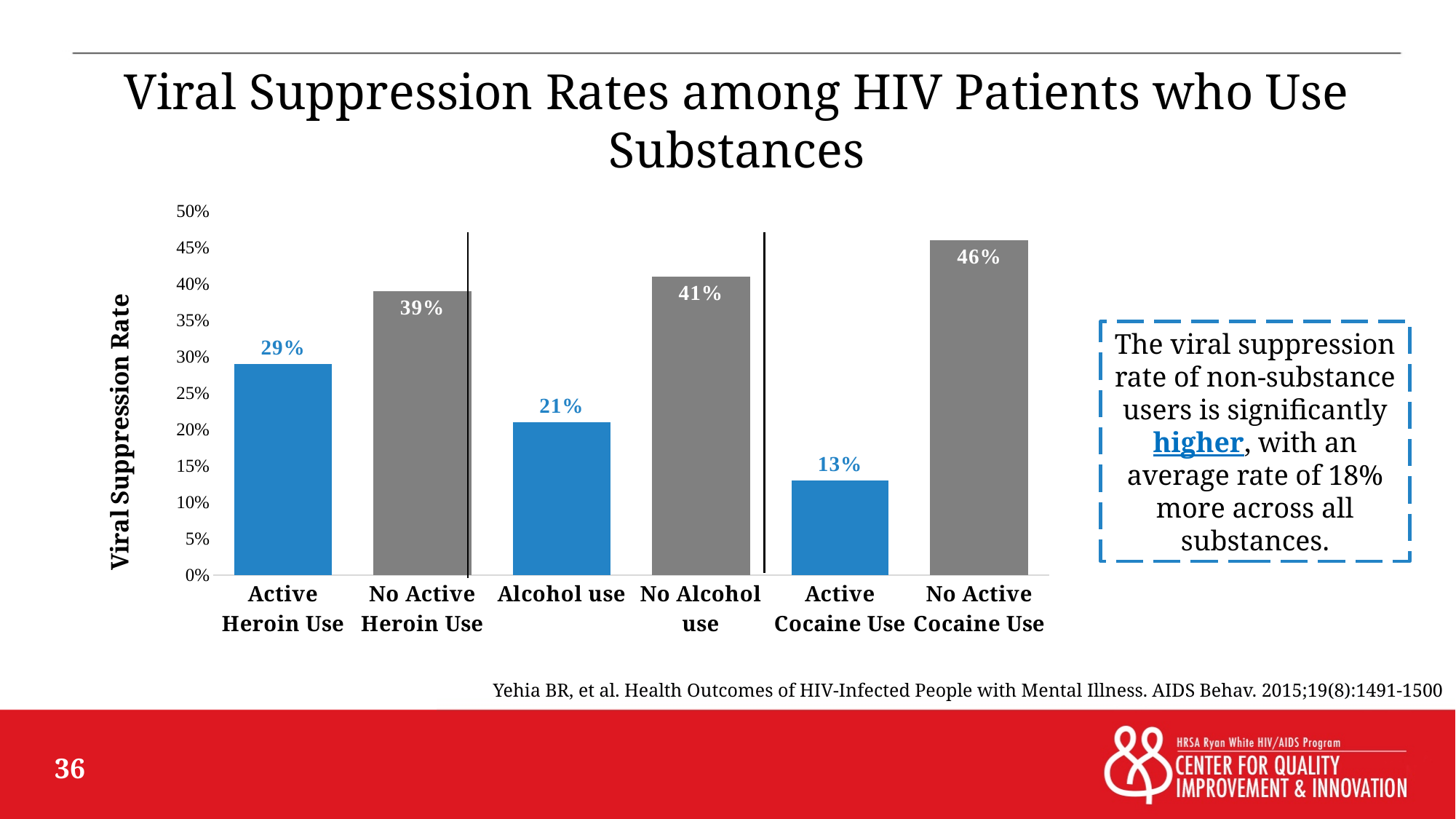
Which category has the highest viral suppression rate? No Active Cocaine Use What is the viral suppression rate for Active Cocaine Use? 13% What kind of chart is shown on the slide? Bar chart What is the difference in viral suppression rate between No Active Cocaine Use and Active Cocaine Use? 33% What is the label of the vertical axis of the chart? Viral Suppression Rate What is the viral suppression rate for No Alcohol use? 41% How many categories are shown on the x axis of the chart? 6 What is the difference in viral suppression rate between No Active Heroin Use and Active Heroin Use? 10% What is the viral suppression rate for Active Heroin Use? 29% Which has a higher viral suppression rate, Alcohol use or Active Heroin Use? Active Heroin Use Is the viral suppression rate for No Alcohol use greater or less than 40%? greater Which category has the lowest viral suppression rate? Active Cocaine Use